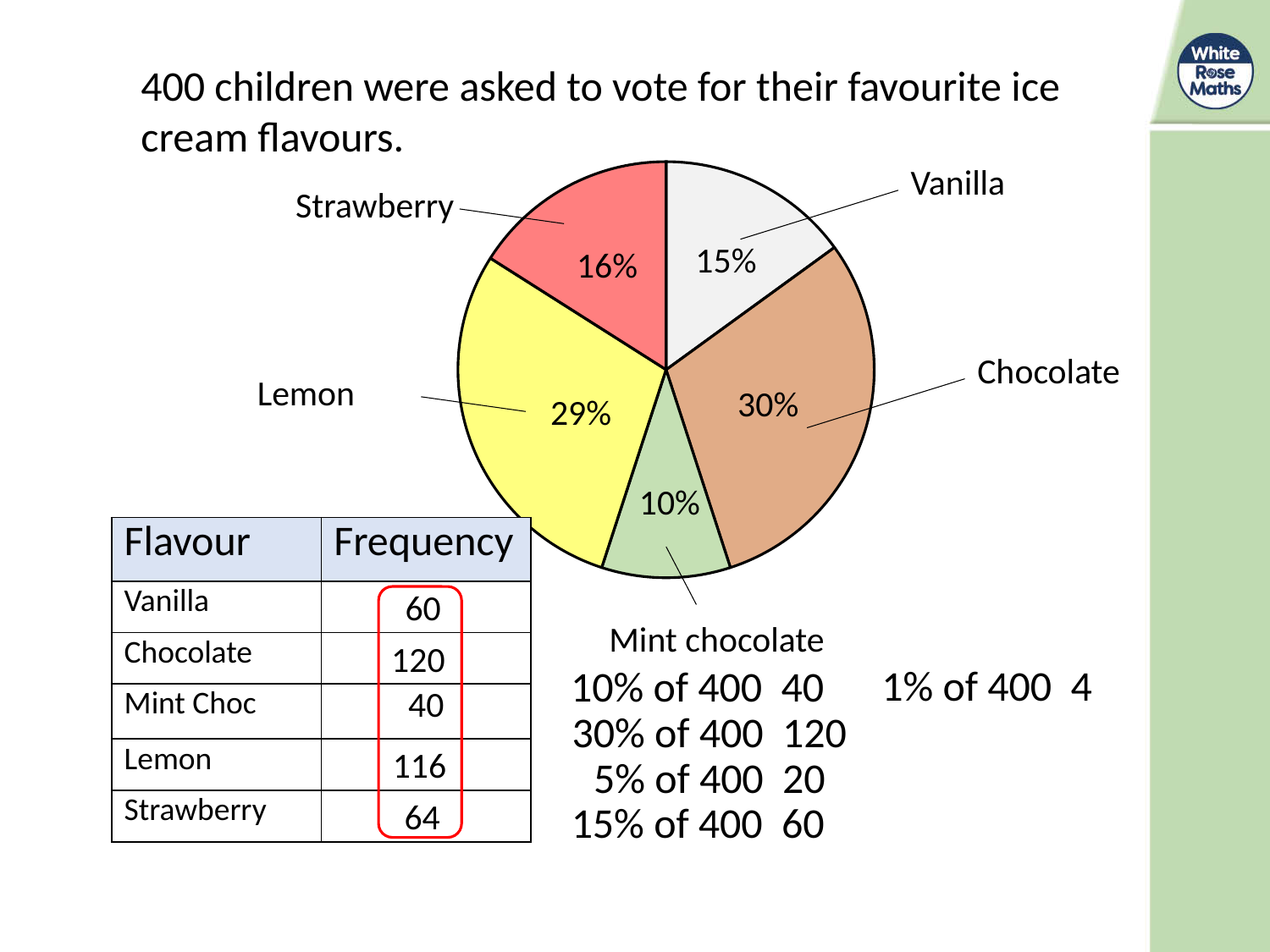
What percentage of the pie chart is Lemon? 29% What is the difference in percentage points between the Chocolate and Vanilla slices? 15 Which flavour has the smallest slice of the pie chart? Mint chocolate Which slice is larger, Strawberry or Vanilla? Strawberry What percentage of the pie chart is Mint chocolate? 10% What colour is the Lemon slice of the pie chart? yellow What percentage of the pie chart is Vanilla? 15% What percentage of the pie chart is Chocolate? 30% How many slices does the pie chart have? 5 What kind of chart is shown on the slide? pie chart What percentage of the pie chart is Strawberry? 16% Which flavour has the largest slice of the pie chart? Chocolate